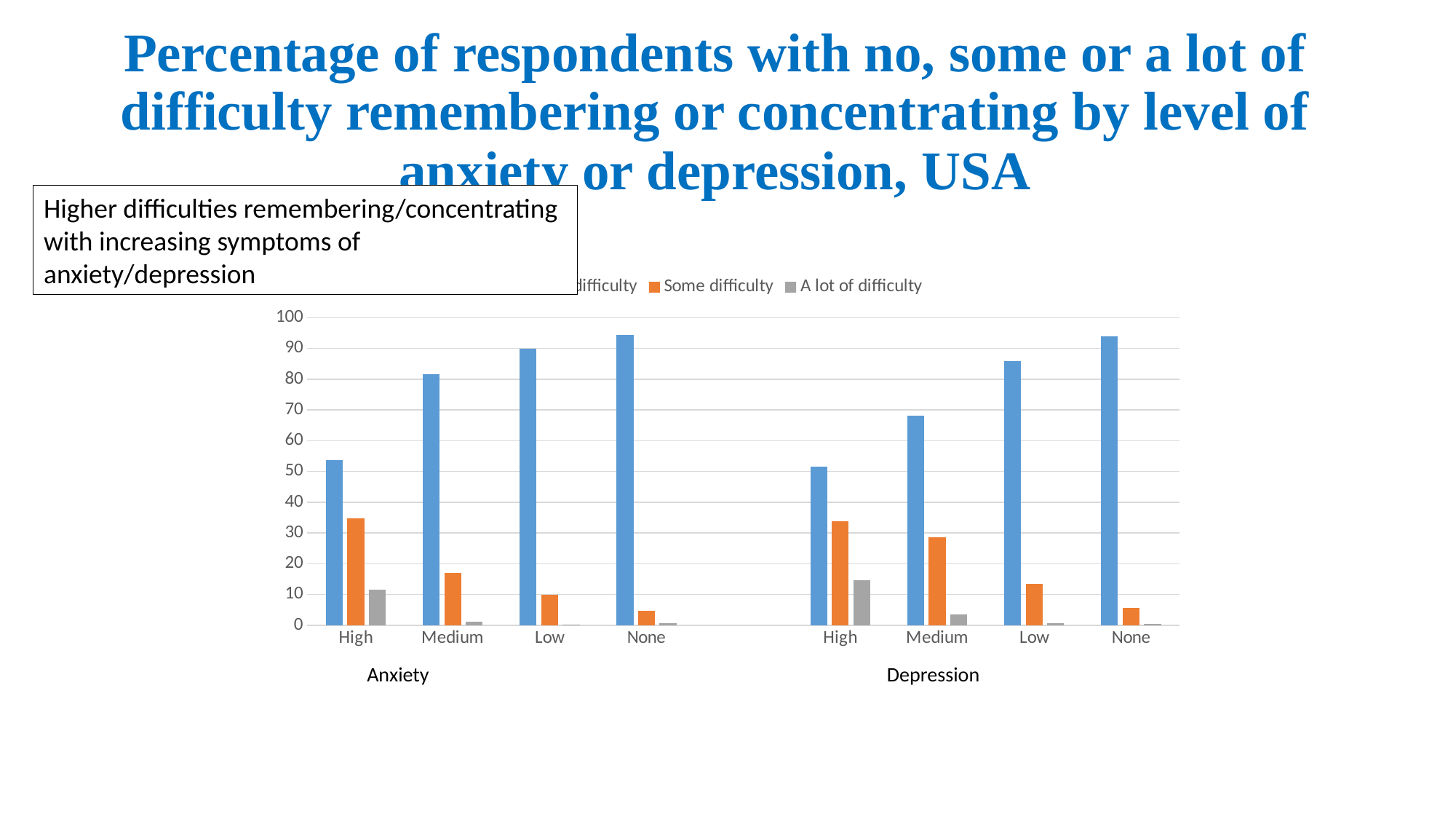
Is the 'No difficulty' (blue) value for Low depression greater or less than 90? less Which is larger, the 'No difficulty' (blue) value for Medium anxiety or for Medium depression? Medium anxiety What are the two group labels shown beneath the x axis of the chart? Anxiety and Depression Is the 'No difficulty' (blue) value for Medium depression greater or less than 70? less How many category groups are shown along the x axis of the chart? 8 Is the 'A lot of difficulty' value for High depression greater or less than 10? greater What kind of chart is shown on the slide? bar chart Which category has the highest 'A lot of difficulty' value? High depression Within the Anxiety group, do the 'No difficulty' (blue) bars rise or fall from High to None? rise